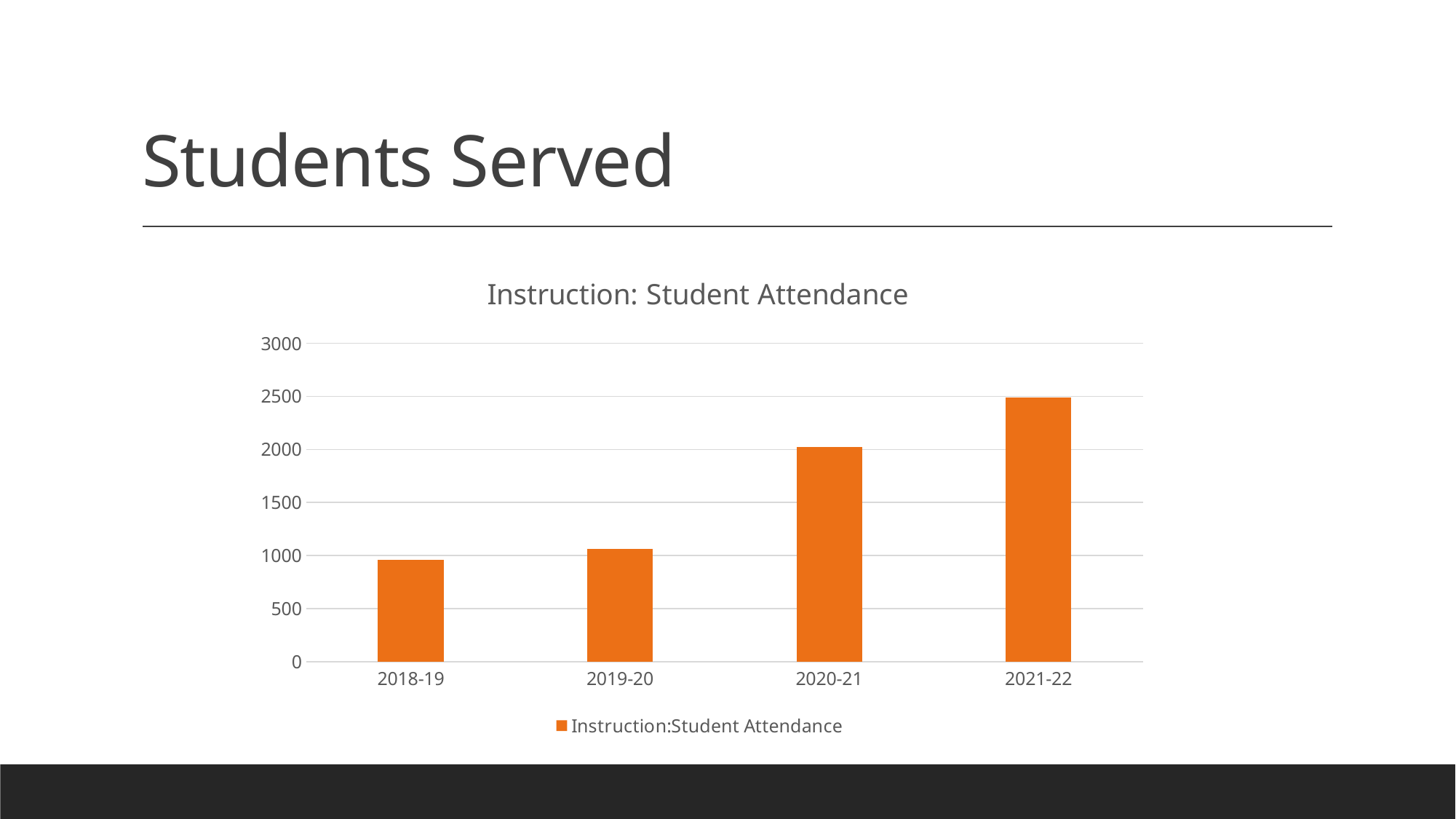
Which year has the lowest student attendance? 2018-19 Which year has the highest student attendance? 2021-22 Is the value for 2019-20 greater or less than 1000? greater Is the value for 2018-19 greater or less than 1000? less Is the value for 2020-21 greater or less than 1500? greater How many years are shown on the x axis? 4 What is the title of the chart? Instruction: Student Attendance Which is larger, the value for 2020-21 or the value for 2019-20? 2020-21 What kind of chart is shown on the slide? bar chart Do the values rise or fall from 2018-19 to 2021-22? rise How many series does the legend list? 1